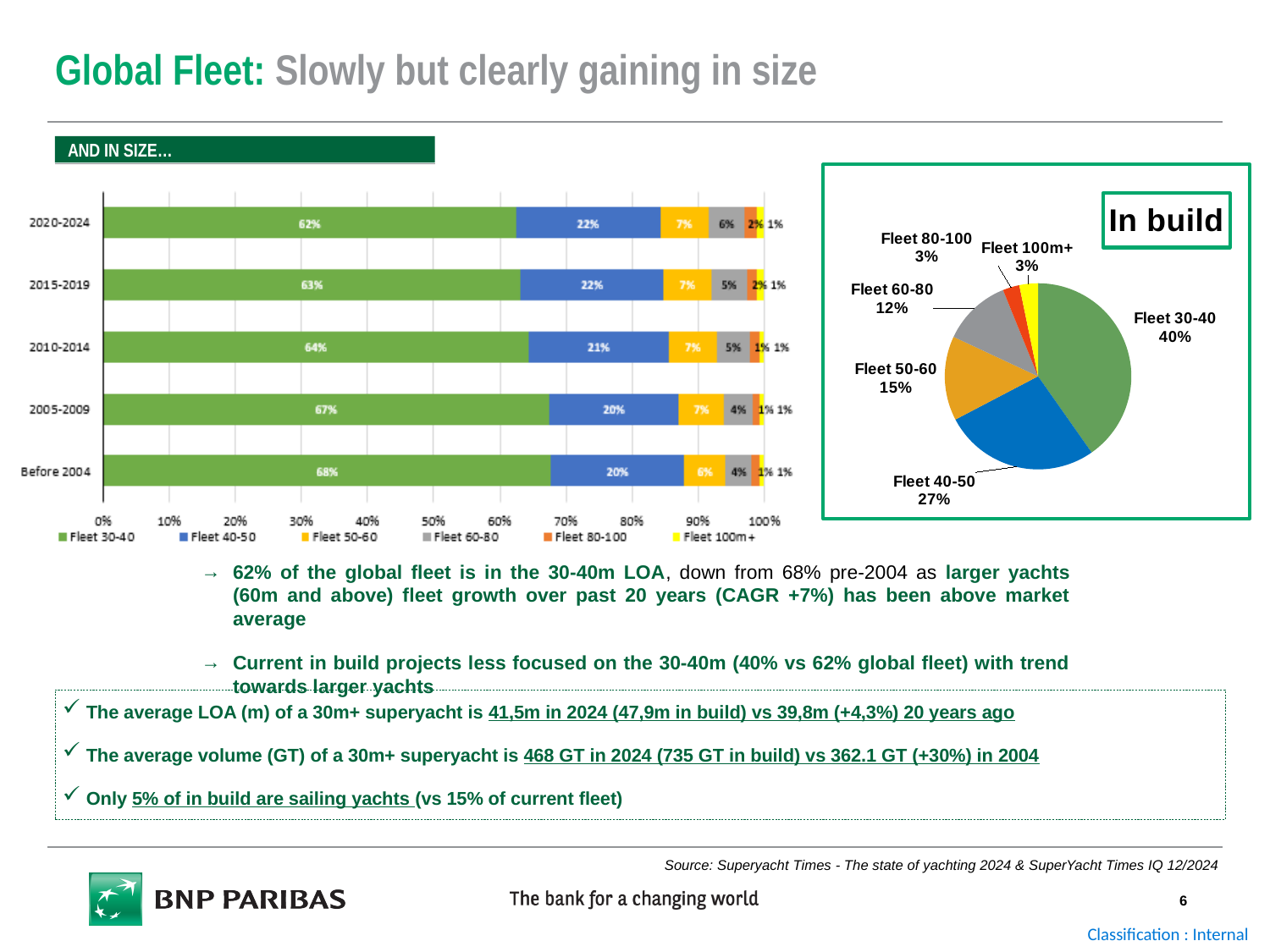
In the 'In build' pie chart, what is the share of Fleet 40-50? 27% In the 'In build' pie chart, which is larger, Fleet 50-60 or Fleet 60-80? Fleet 50-60 In the stacked bar chart on the left, how many periods are shown on the vertical axis? 5 In the stacked bar chart on the left, what is the difference between the Fleet 30-40 share for Before 2004 and for 2020-2024? 6% In the stacked bar chart on the left, does the share of Fleet 30-40 rise or fall from Before 2004 to 2020-2024? fall In the stacked bar chart on the left, what is the share of Fleet 30-40 for Before 2004? 68% In the 'In build' pie chart, which category has the largest slice? Fleet 30-40 In the stacked bar chart on the left, what is the share of Fleet 30-40 for 2020-2024? 62% In the stacked bar chart on the left, what is the share of Fleet 40-50 for 2010-2014? 21% What kind of chart is the chart on the right of the slide? pie chart In the stacked bar chart on the left, how many series does the legend list? 6 In the stacked bar chart on the left, which period has the highest share of Fleet 30-40? Before 2004